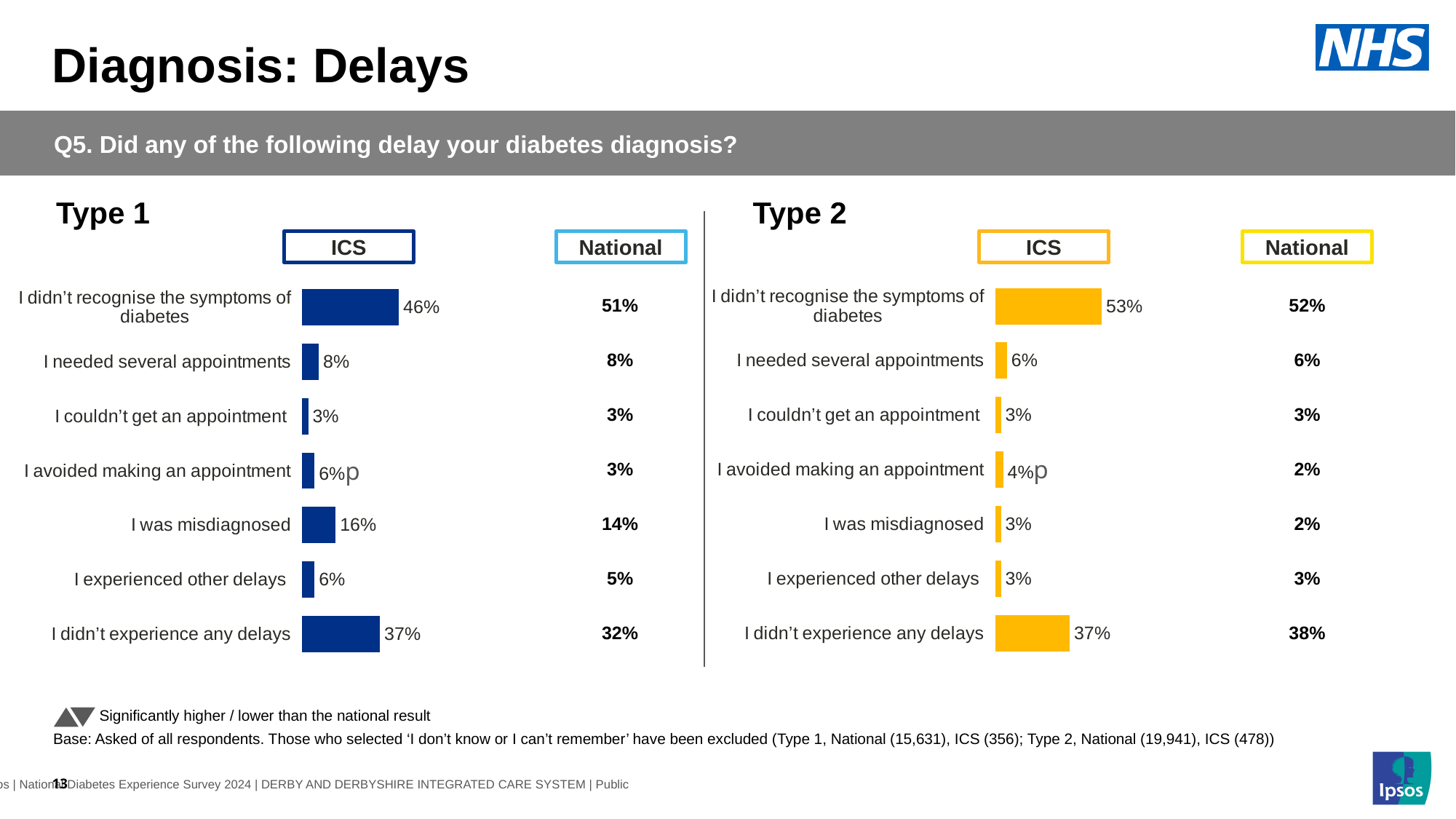
In the Type 1 chart, what is the difference between the ICS and National values for 'I didn't experience any delays'? 5 percentage points In the Type 2 chart, what is the ICS value for 'I didn't experience any delays'? 37% In the Type 2 chart, what is the difference between the ICS and National values for 'I avoided making an appointment'? 2 percentage points In the Type 2 chart, which category has the lowest National value? I avoided making an appointment and I was misdiagnosed (both 2%) What type of chart is used to show the ICS values in the Type 2 chart? bar chart In the Type 1 chart, what is the ICS value for 'I didn't recognise the symptoms of diabetes'? 46% In the Type 2 chart, is the ICS value for 'I didn't recognise the symptoms of diabetes' higher or lower than the National value? higher How many categories are shown in the Type 1 chart? 7 In the Type 1 chart, which category has the highest ICS value? I didn't recognise the symptoms of diabetes In the Type 1 chart, is the ICS value for 'I was misdiagnosed' higher or lower than the National value? higher In the Type 1 chart, what is the National value for 'I was misdiagnosed'? 14% In the Type 2 chart, what is the National value for 'I didn't recognise the symptoms of diabetes'? 52%